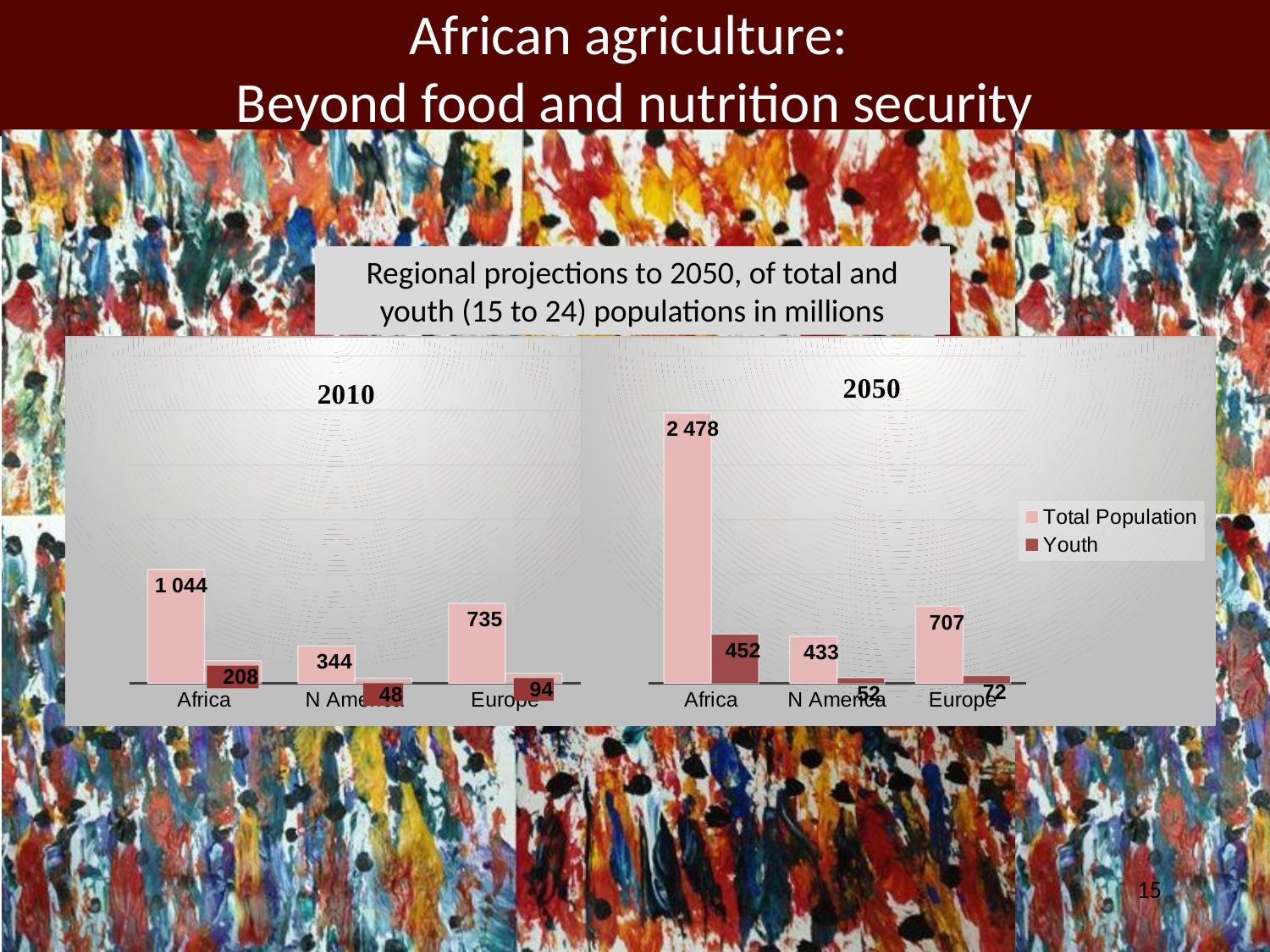
What type of chart is the 2050 chart? bar chart In the 2010 chart, what is the Total Population value for Africa? 1 044 In the 2050 chart, what is the Total Population value for Europe? 707 In the 2010 chart, which is larger: the Total Population for Europe or for N America? Europe How many series does the legend list? 2 In the 2050 chart, which region has the highest Total Population? Africa In the 2010 chart, what is the Youth value for N America? 48 What is the title of the chart on the left? 2010 In the 2010 chart, which region has the lowest Youth value? N America How many regions are shown in the 2010 chart? 3 In the 2050 chart, what is the Youth value for Africa? 452 In the 2050 chart, what is the difference between the Total Population values for Africa and Europe? 1 771